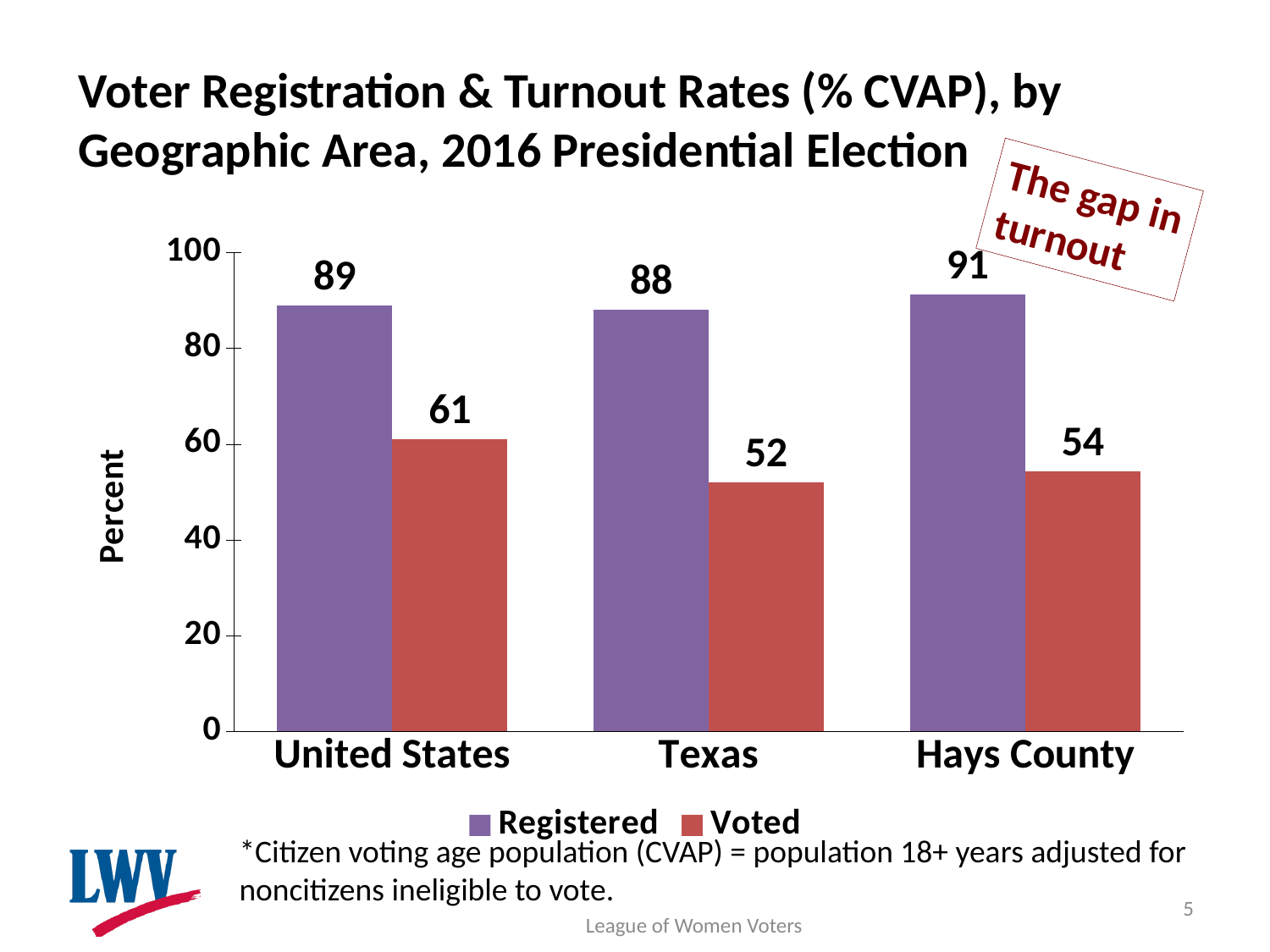
Which is larger, the Voted value for the United States or the Voted value for Texas? United States Which geographic area has the lowest Voted value? Texas What is the difference between the Voted values for the United States and Hays County? 7 How many series does the legend list? 2 What is the Voted value for the United States? 61 What kind of chart is shown on the slide? bar chart Which geographic area has the highest Registered value? Hays County Is the Voted value for Hays County greater or less than 60? less How many geographic areas are shown on the x axis? 3 What is the Voted value for Hays County? 54 What is the Registered value for Texas? 88 What is the difference between the Registered and Voted values for Texas? 36